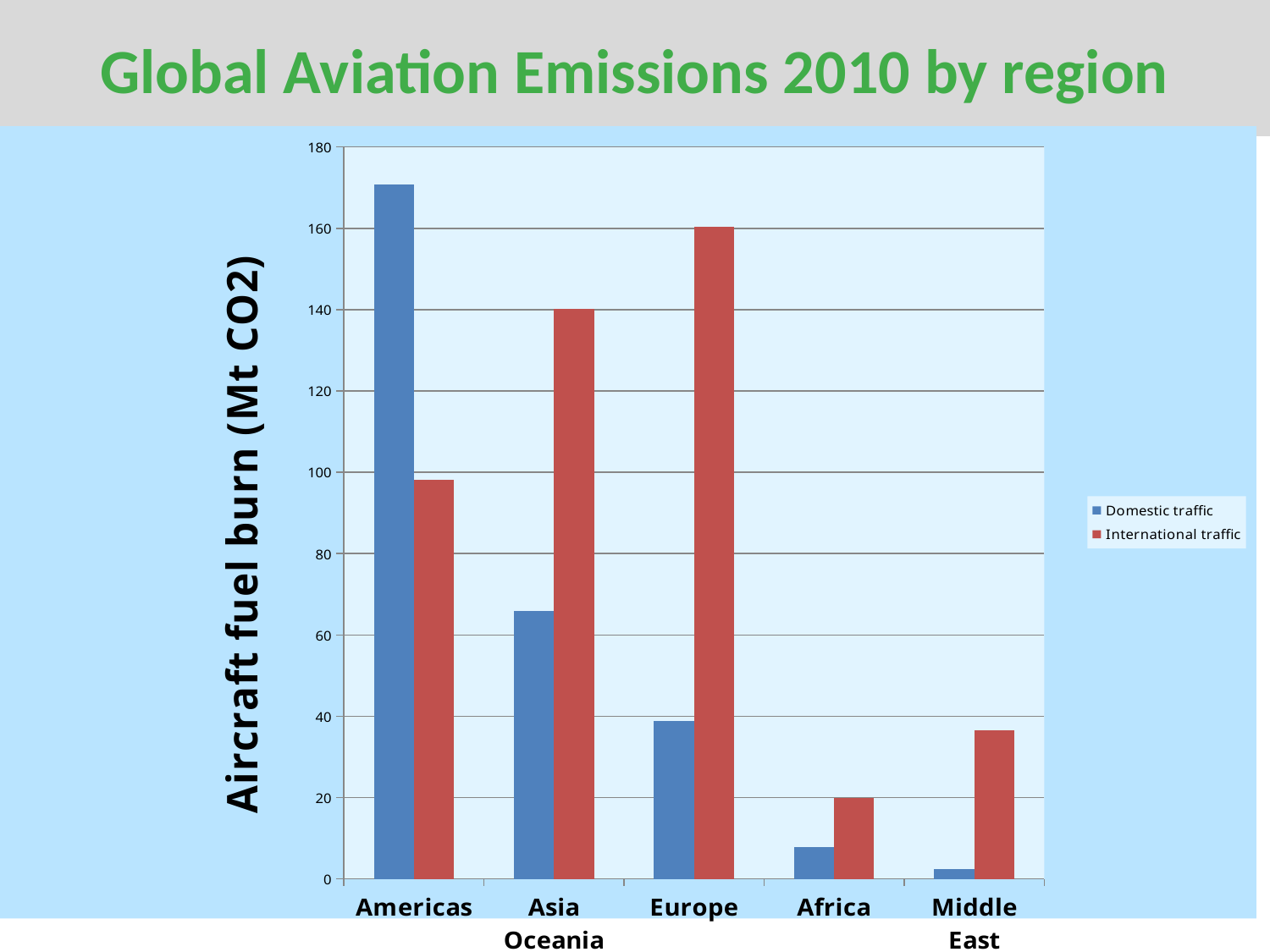
Which region has the highest International traffic value? Europe How many regions are shown on the x axis? 5 What is the label on the vertical axis? Aircraft fuel burn (Mt CO2) How many series does the legend list? 2 For Europe, which is larger: Domestic traffic or International traffic? International traffic Which region has the lowest International traffic value? Africa Which region has the highest Domestic traffic value? Americas For the Americas, which is larger: Domestic traffic or International traffic? Domestic traffic Is the Domestic traffic value for the Americas greater or less than 160? greater Which region has the lowest Domestic traffic value? Middle East Is the International traffic value for the Middle East greater or less than 40? less What kind of chart is shown on the slide? bar chart